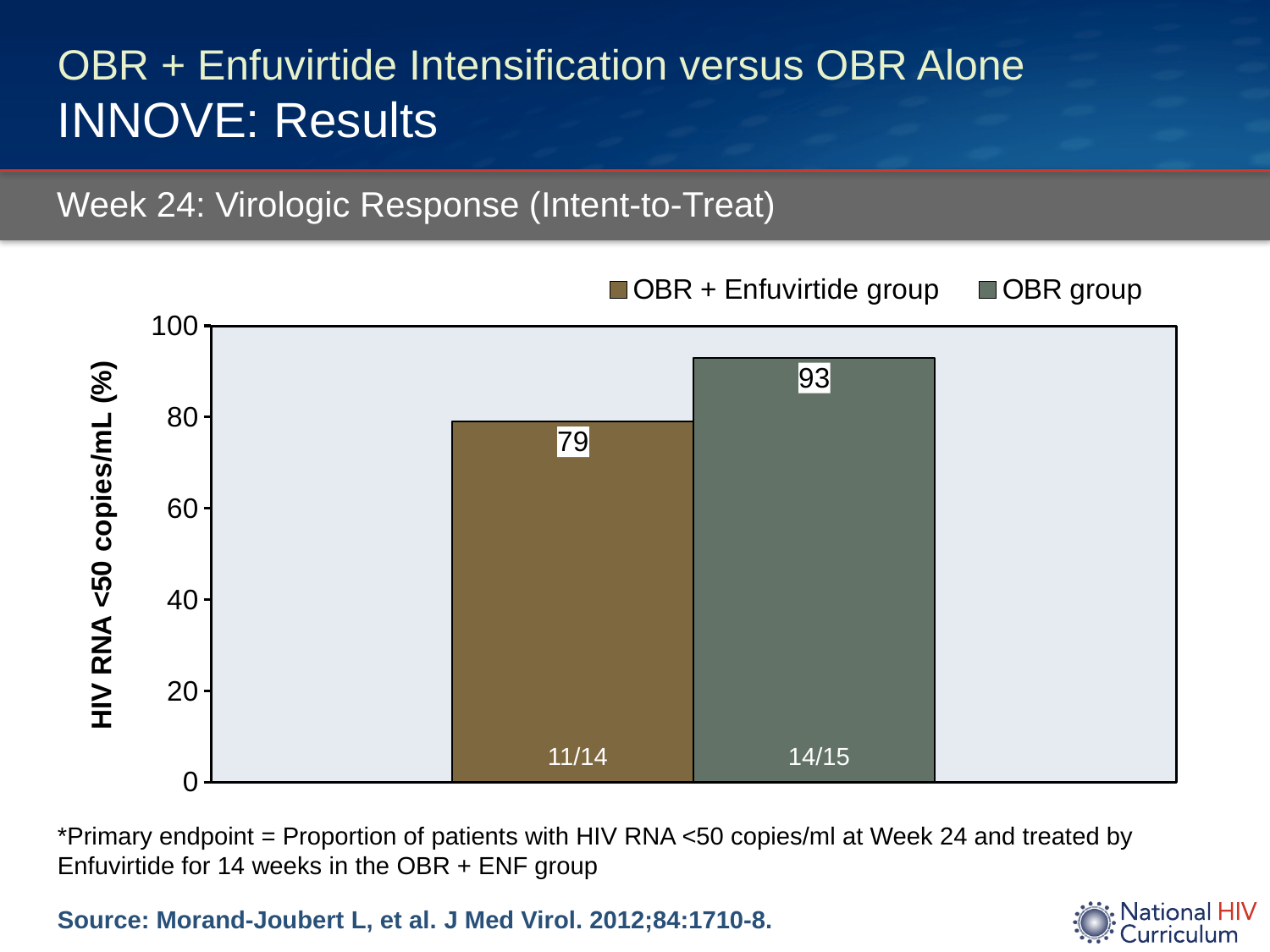
What fraction of patients is shown at the base of the OBR + Enfuvirtide group bar? 11/14 Is the value for the OBR group greater or less than 80? greater What kind of chart is shown on the slide? Bar chart What fraction of patients is shown at the base of the OBR group bar? 14/15 What is the value for the OBR group? 93 Which group has the higher percentage of patients with HIV RNA <50 copies/mL? OBR group What is the label of the y axis? HIV RNA <50 copies/mL (%) What is the difference between the OBR group value and the OBR + Enfuvirtide group value? 14 What is the value for the OBR + Enfuvirtide group? 79 Which group has the lower percentage of patients with HIV RNA <50 copies/mL? OBR + Enfuvirtide group How many series does the legend list? 2 Is the value for the OBR + Enfuvirtide group greater or less than 80? less